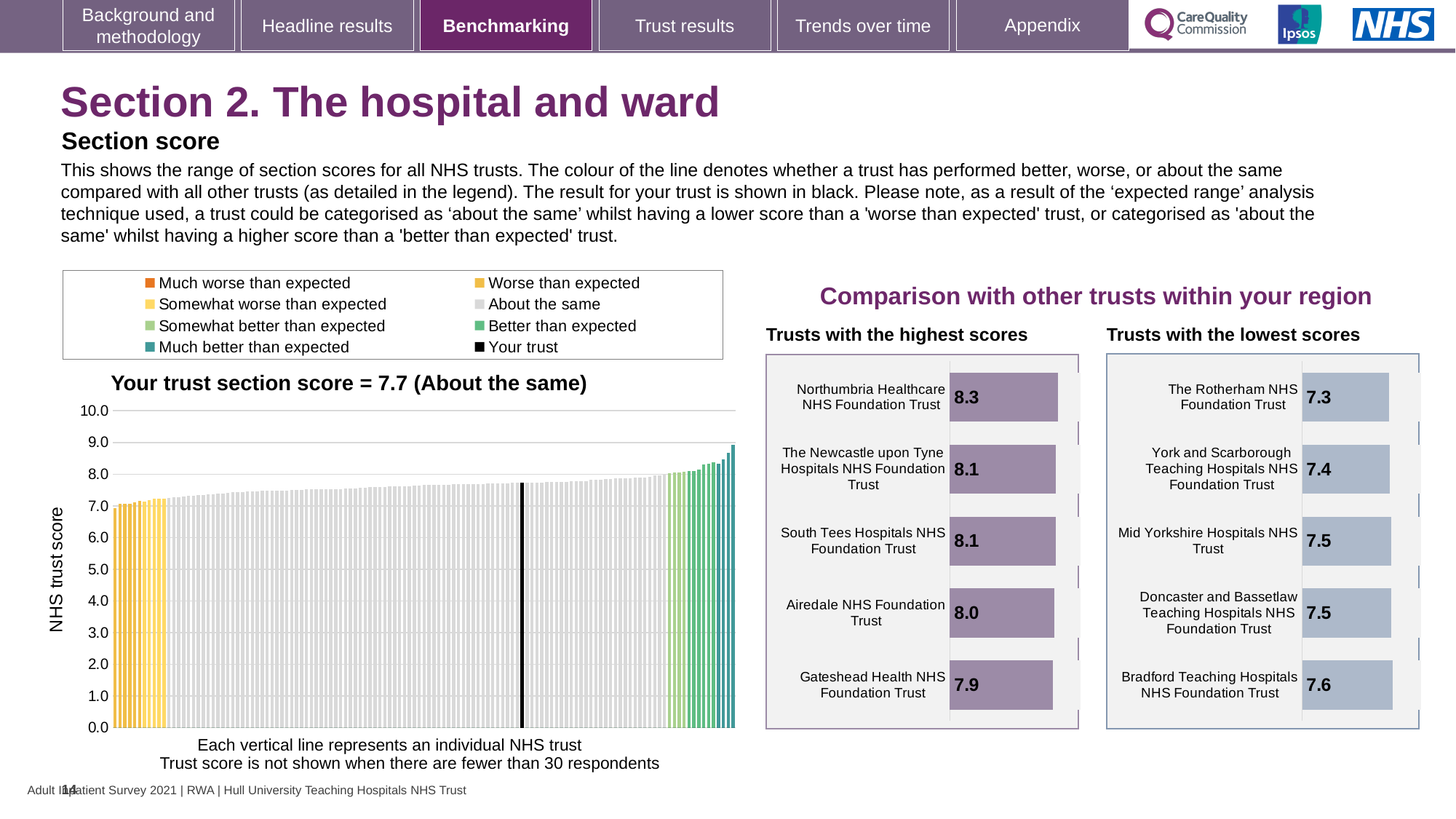
How many trusts are shown in the 'Trusts with the lowest scores' chart? 5 In the 'Trusts with the lowest scores' chart, what is the score for Bradford Teaching Hospitals NHS Foundation Trust? 7.6 In the main chart on the left, is the value of the highest bar greater or less than 8.0? greater In the 'Trusts with the highest scores' chart, what is the score for Northumbria Healthcare NHS Foundation Trust? 8.3 In the 'Trusts with the highest scores' chart, what is the score for Gateshead Health NHS Foundation Trust? 7.9 In the 'Trusts with the lowest scores' chart, what is the score for The Rotherham NHS Foundation Trust? 7.3 In the 'Trusts with the highest scores' chart, what is the difference between the scores of Northumbria Healthcare NHS Foundation Trust and Airedale NHS Foundation Trust? 0.3 In the 'Trusts with the highest scores' chart, which trust has the highest score? Northumbria Healthcare NHS Foundation Trust In the 'Trusts with the lowest scores' chart, which trust has the lowest score? The Rotherham NHS Foundation Trust In the main chart on the left, what is your trust's section score? 7.7 What kind of chart is the main chart on the left showing NHS trust scores? Bar chart In the 'Trusts with the lowest scores' chart, which has the larger score: York and Scarborough Teaching Hospitals NHS Foundation Trust or Bradford Teaching Hospitals NHS Foundation Trust? Bradford Teaching Hospitals NHS Foundation Trust